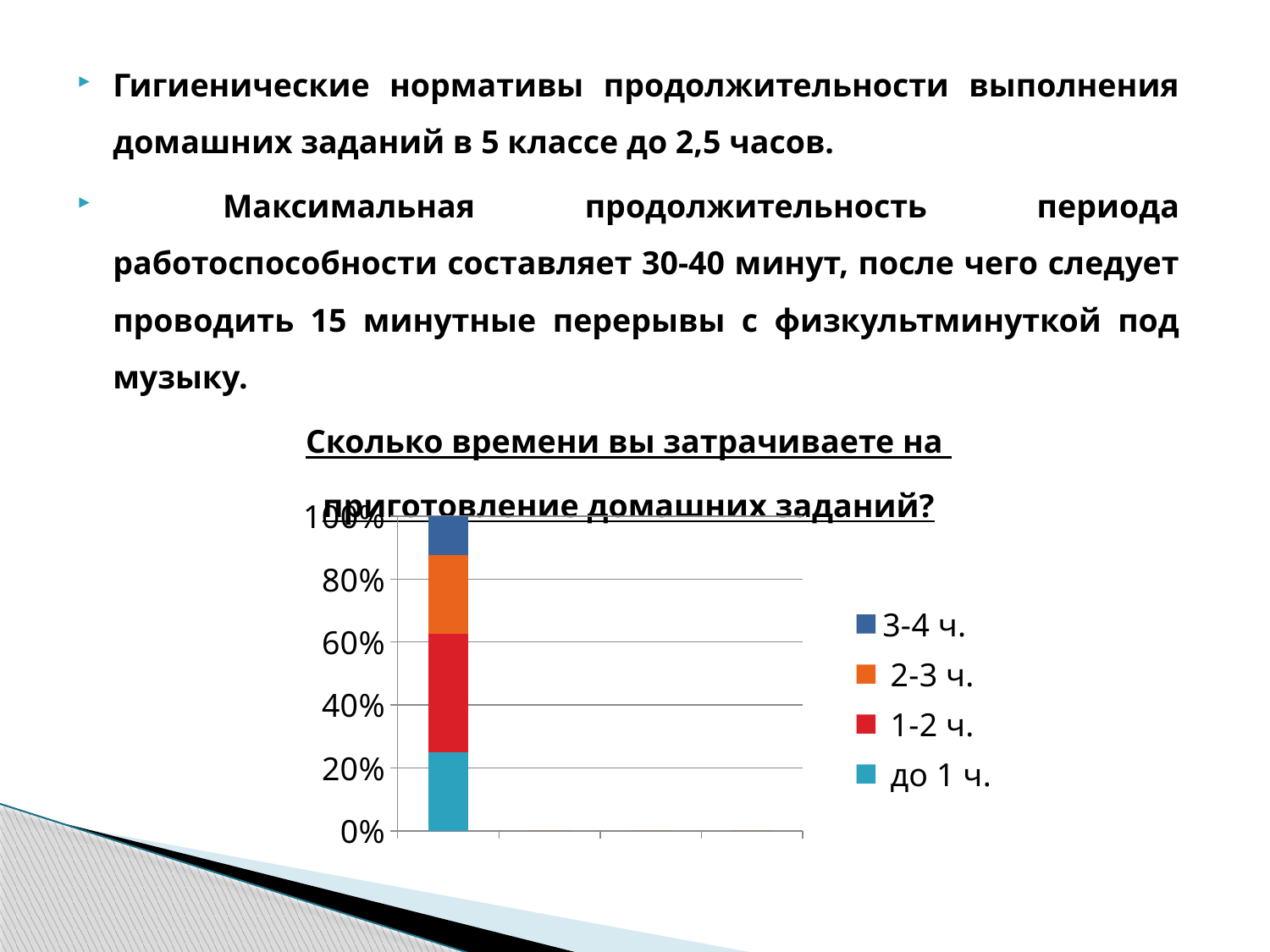
Which segment is larger, 1-2 ч. or 2-3 ч.? 1-2 ч. How many series does the chart legend list? 4 Which segment is larger, до 1 ч. or 3-4 ч.? до 1 ч. What is the title of the chart? Сколько времени вы затрачиваете на приготовление домашних заданий? How many bars are plotted in the chart? 1 Which series occupies the smallest segment of the stacked bar? 3-4 ч. What kind of chart is shown on the slide? stacked bar chart Is the share for 3-4 ч. greater or less than 20%? less Is the share for 1-2 ч. greater or less than 20%? greater Which series is shown in red in the legend? 1-2 ч. What value does the top of the stacked bar reach on the axis? 100% Which series occupies the largest segment of the stacked bar? 1-2 ч.